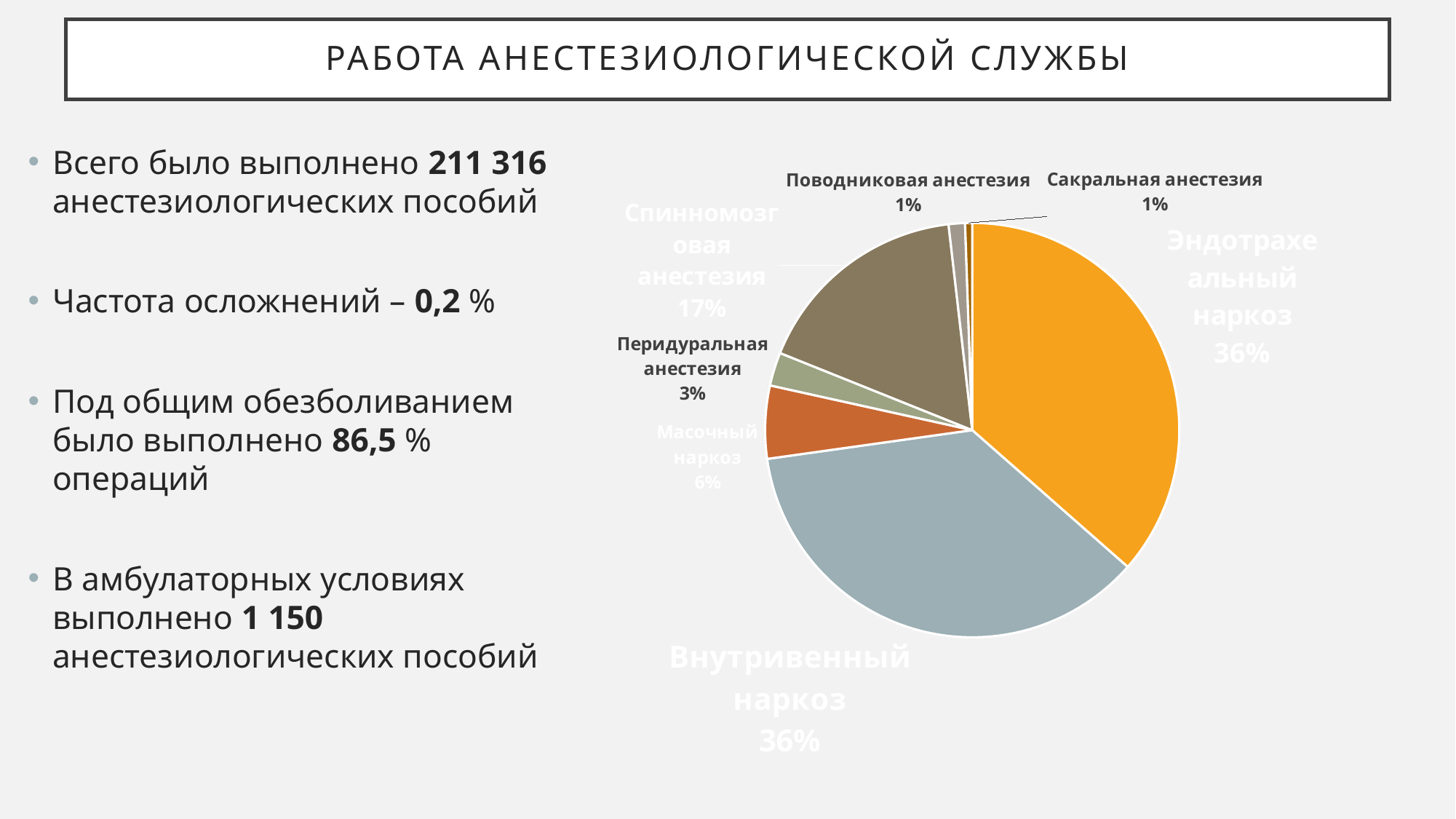
What share of the pie does Перидуральная анестезия have? 3% How many slices does the pie chart have? 7 What is the combined share of Эндотрахеальный наркоз and Внутривенный наркоз? 72% What share of the pie does Эндотрахеальный наркоз have? 36% What share of the pie does Внутривенный наркоз have? 36% Which has a larger share, Масочный наркоз or Перидуральная анестезия? Масочный наркоз What share of the pie does Поводниковая анестезия have? 1% What is the difference in share between Спинномозговая анестезия and Масочный наркоз? 11% What share of the pie does Спинномозговая анестезия have? 17% What kind of chart is shown on the slide? pie chart What share of the pie does Масочный наркоз have? 6% Which has a larger share, Спинномозговая анестезия or Сакральная анестезия? Спинномозговая анестезия